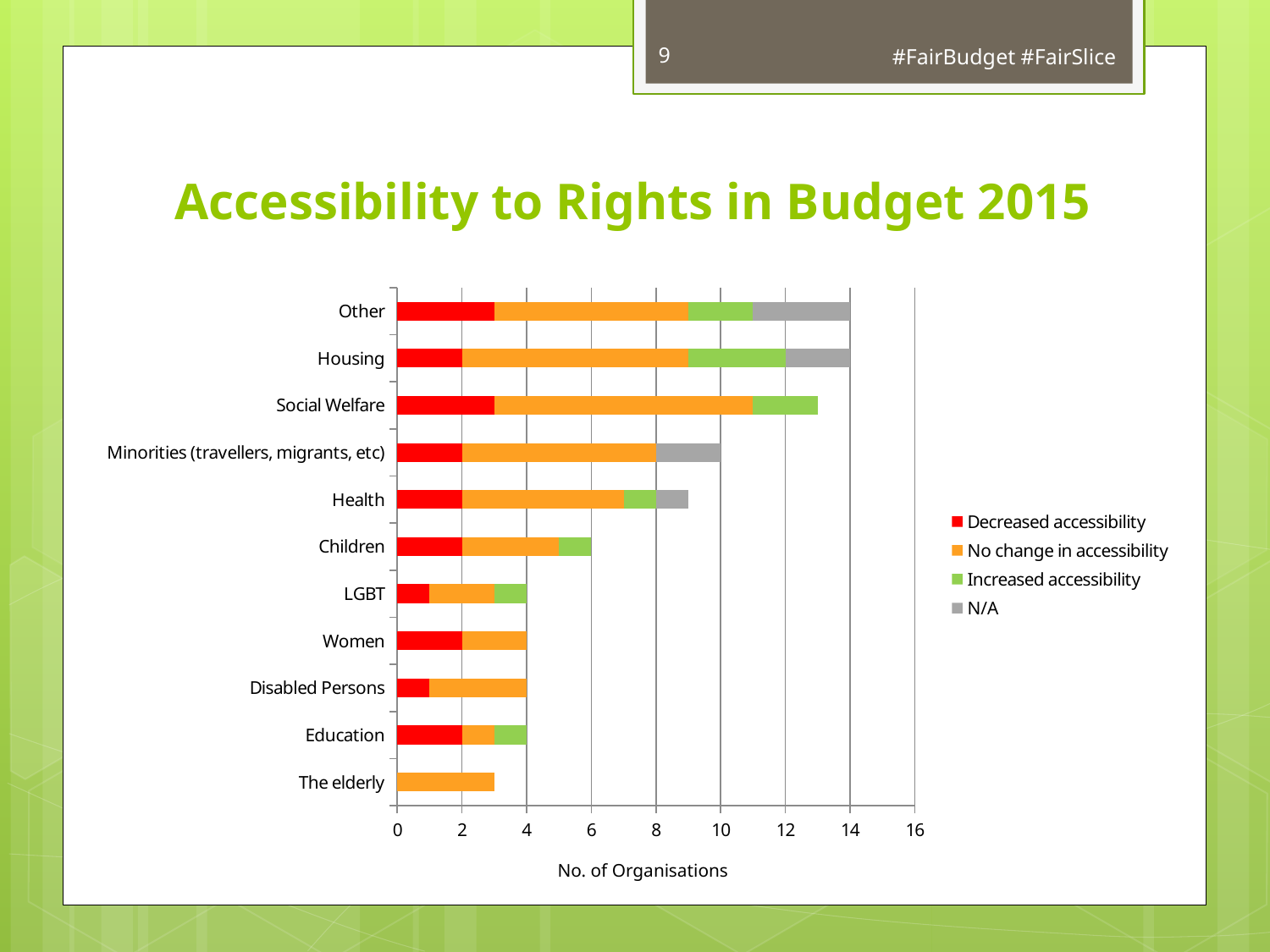
What is the total number of organisations for the Minorities (travellers, migrants, etc) bar? 10 What is the total number of organisations for the Children bar? 6 How many categories are plotted on the y axis? 11 What kind of chart is shown on the slide? Stacked bar chart What is the title of the x axis? No. of Organisations Is the total for Social Welfare greater or less than 12? greater How many organisations reported Decreased accessibility for Housing? 2 Is the total for Health greater or less than 10? less Which category has the shortest total bar? The elderly Which has the larger total bar, Social Welfare or Health? Social Welfare What is the total number of organisations for the Housing bar? 14 How many series does the legend list? 4